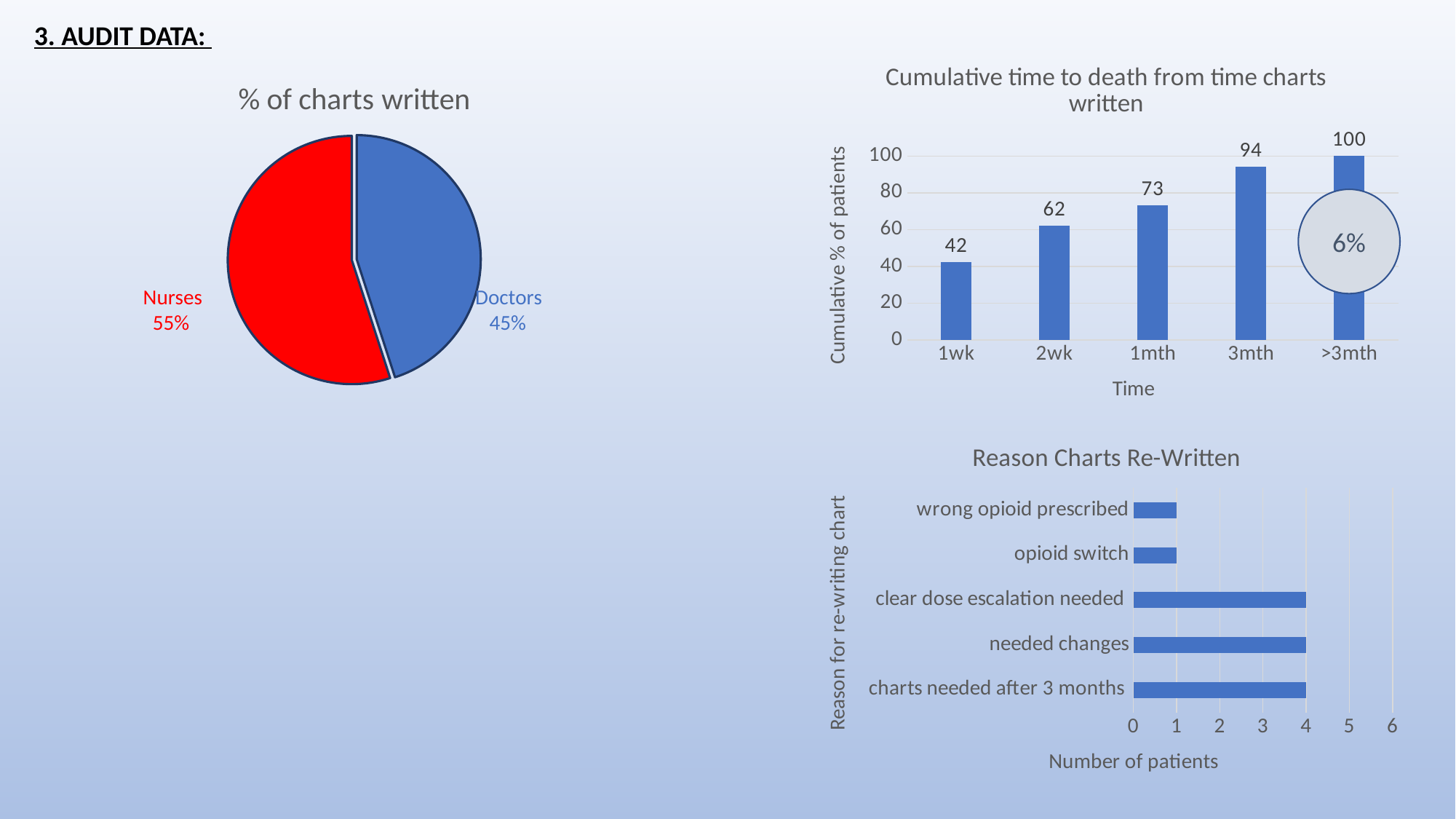
In the 'Cumulative time to death from time charts written' chart, what is the cumulative % of patients at 2wk? 62 In the 'Reason Charts Re-Written' chart, how many patients are shown for 'opioid switch'? 1 In the 'Reason Charts Re-Written' chart, how many patients are shown for 'needed changes'? 4 In the 'Cumulative time to death from time charts written' chart, how many time categories are shown on the x axis? 5 In the '% of charts written' pie chart, what share of charts were written by Nurses? 55% In the 'Cumulative time to death from time charts written' chart, what is the difference between the values at 1mth and 1wk? 31 In the '% of charts written' pie chart, what share of charts were written by Doctors? 45% In the '% of charts written' pie chart, which group wrote the larger share of charts, Nurses or Doctors? Nurses What kind of chart is 'Reason Charts Re-Written'? Bar chart In the 'Cumulative time to death from time charts written' chart, do the values rise or fall from 1wk to >3mth? Rise What kind of chart is '% of charts written'? Pie chart In the 'Cumulative time to death from time charts written' chart, what is the cumulative % of patients at 3mth? 94